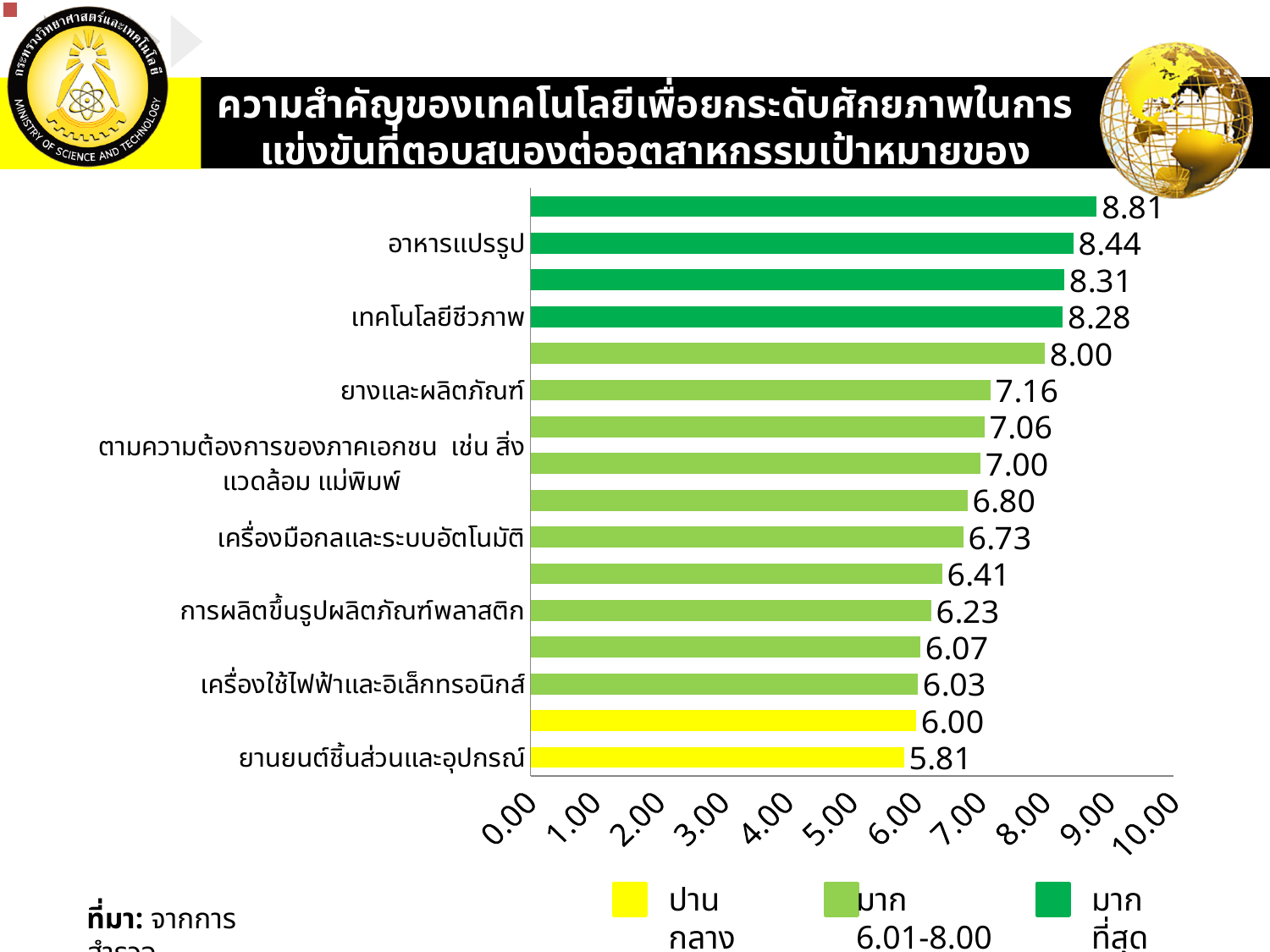
What is the value for เครื่องมือกลและระบบอัตโนมัติ? 6.73 What is the difference between the values for อาหารแปรรูป and เทคโนโลยีชีวภาพ? 0.16 What is the value for เทคโนโลยีชีวภาพ? 8.28 What is the highest value shown on the chart? 8.81 How many bars are plotted on the chart? 16 What is the value for ยานยนต์ชิ้นส่วนและอุปกรณ์? 5.81 What is the value for อาหารแปรรูป? 8.44 How many entries does the legend list? 3 What kind of chart is shown on the slide? Bar chart Which labelled category has the lowest value? ยานยนต์ชิ้นส่วนและอุปกรณ์ What is the value for ยางและผลิตภัณฑ์? 7.16 Which is larger, the value for การผลิตขึ้นรูปผลิตภัณฑ์พลาสติก or the value for เครื่องใช้ไฟฟ้าและอิเล็กทรอนิกส์? การผลิตขึ้นรูปผลิตภัณฑ์พลาสติก